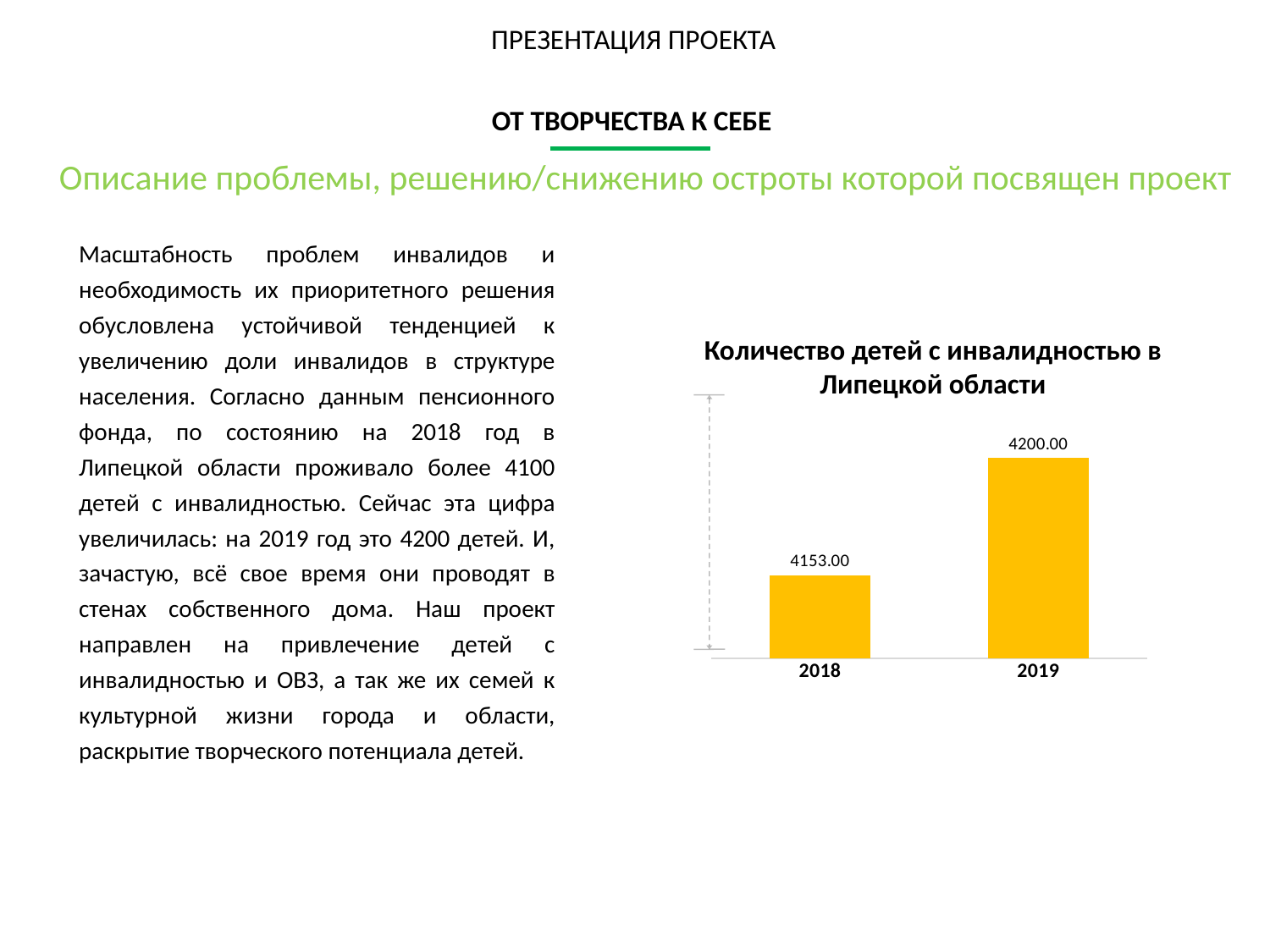
What is the value for 2019 in the chart? 4200.00 Which year has the lowest value in the chart? 2018 Which is larger, the value for 2018 or the value for 2019? 2019 What is the value for 2018 in the chart? 4153.00 What colour are the bars in the chart? Yellow What kind of chart is shown on the slide? Bar chart Do the values rise or fall from 2018 to 2019? Rise What is the difference between the values for 2019 and 2018? 47.00 What is the title of the chart? Количество детей с инвалидностью в Липецкой области Which year has the highest value in the chart? 2019 How many categories are shown in the chart? 2